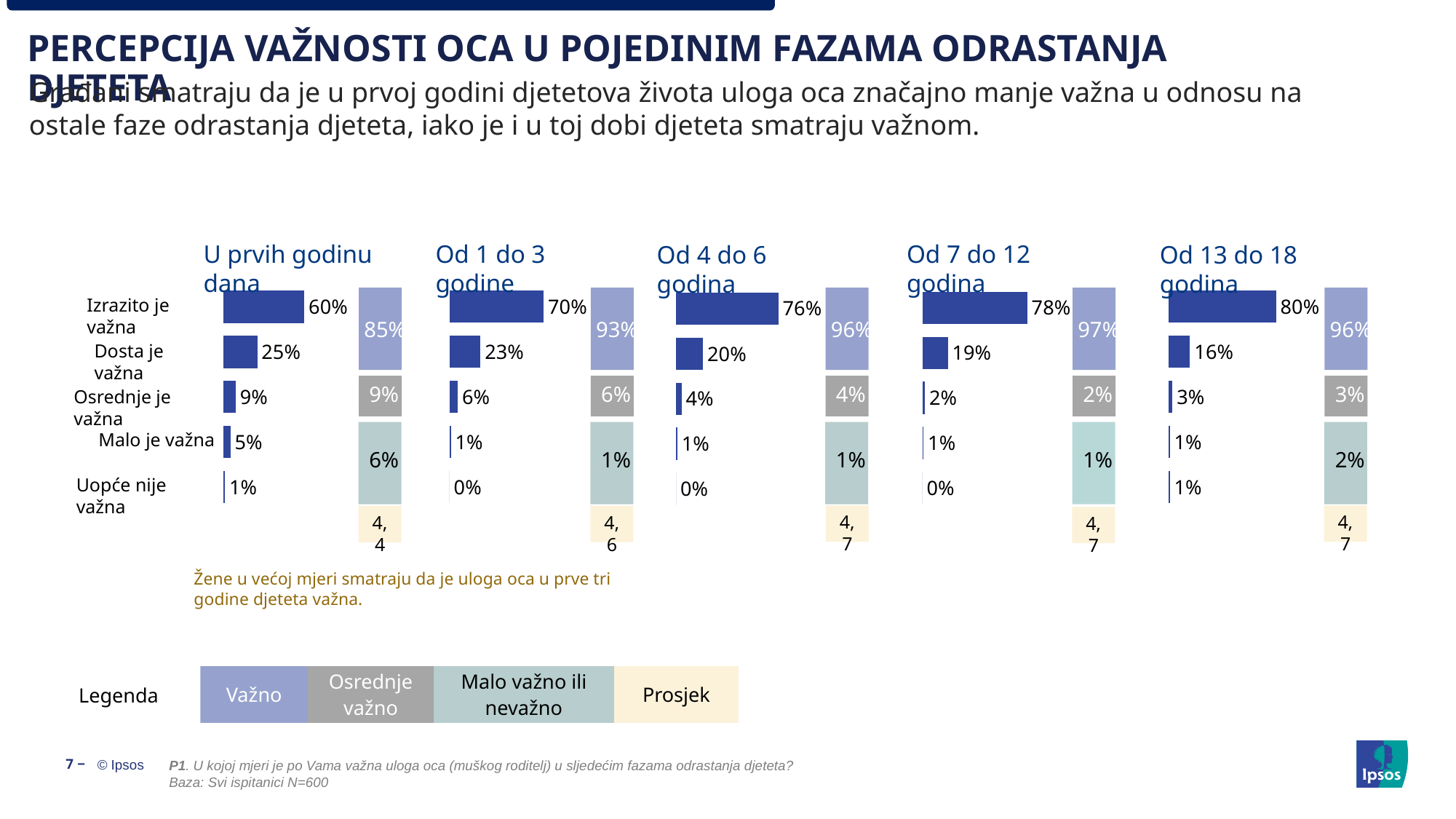
In the 'Od 4 do 6 godina' chart, what is the value for 'Dosta je važna'? 20% In the 'Od 13 do 18 godina' chart, what is the value for 'Izrazito je važna'? 80% In the 'Od 7 do 12 godina' chart, what is the value for 'Osrednje je važna'? 2% In the 'U prvih godinu dana' chart, which category has the lowest value? Uopće nije važna In the 'U prvih godinu dana' chart, what is the value for 'Izrazito je važna'? 60% In the 'U prvih godinu dana' chart, what is the 'Važno' summary value shown in the stacked bar? 85% How many entries does the legend ('Legenda') list? 4 In the 'Od 1 do 3 godine' chart, which category has the highest value? Izrazito je važna In the 'U prvih godinu dana' chart, what is the difference between 'Izrazito je važna' and 'Dosta je važna'? 35% How many categories does the 'Od 1 do 3 godine' chart show? 5 Which is larger: 'Izrazito je važna' in the 'Od 4 do 6 godina' chart or 'Izrazito je važna' in the 'Od 7 do 12 godina' chart? Od 7 do 12 godina What type of chart is used for the 'Od 13 do 18 godina' data? Bar chart